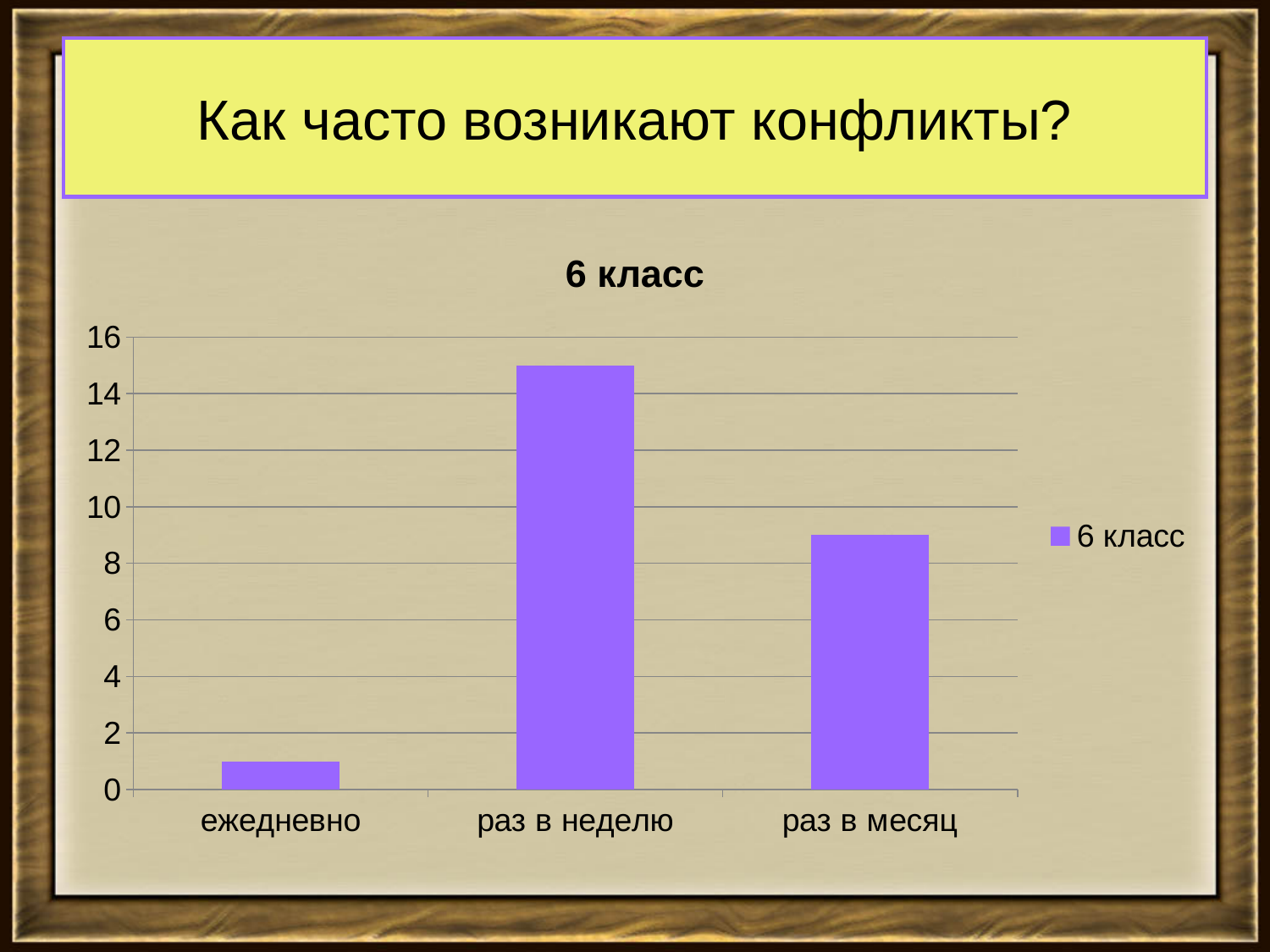
Which is larger, the value for 'раз в месяц' or the value for 'ежедневно'? раз в месяц Is the value for 'ежедневно' greater or less than 2? less What is the title of the chart? 6 класс What kind of chart is shown on the slide? bar chart How many categories are shown on the x axis of the chart? 3 Which category has the highest bar? раз в неделю Is the value for 'раз в месяц' greater or less than 10? less How many series does the chart legend list? 1 Which is larger, the value for 'раз в неделю' or the value for 'раз в месяц'? раз в неделю Which category has the lowest bar? ежедневно What is the name of the series shown in the legend? 6 класс Is the value for 'раз в неделю' greater or less than 14? greater